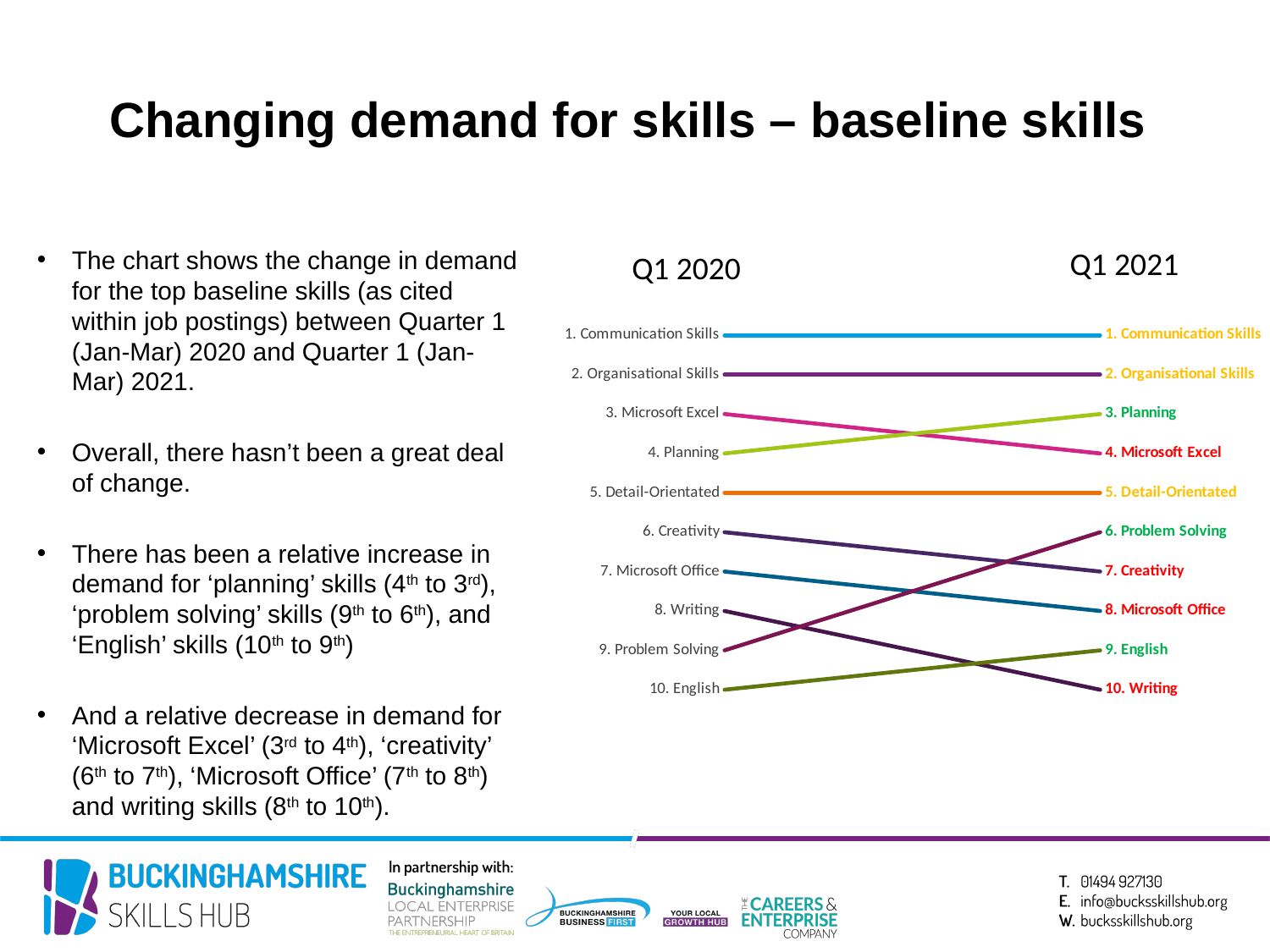
How many skills are ranked in the chart? 10 What rank did Problem Solving hold in Q1 2020? 9 By how many places did Writing's rank change between Q1 2020 and Q1 2021? 2 What kind of chart is shown on the slide? Line chart Which skill was ranked 1st in both Q1 2020 and Q1 2021? Communication Skills Which skill was ranked 10th in Q1 2021? Writing What are the two time periods compared in the chart? Q1 2020 and Q1 2021 What rank did Planning hold in Q1 2021? 3 Did Creativity's rank rise or fall from Q1 2020 to Q1 2021? Fall In Q1 2021, which was ranked higher: Microsoft Excel or Planning? Planning By how many places did Problem Solving's rank change between Q1 2020 and Q1 2021? 3 Which skill was ranked lowest (10th) in Q1 2020? English